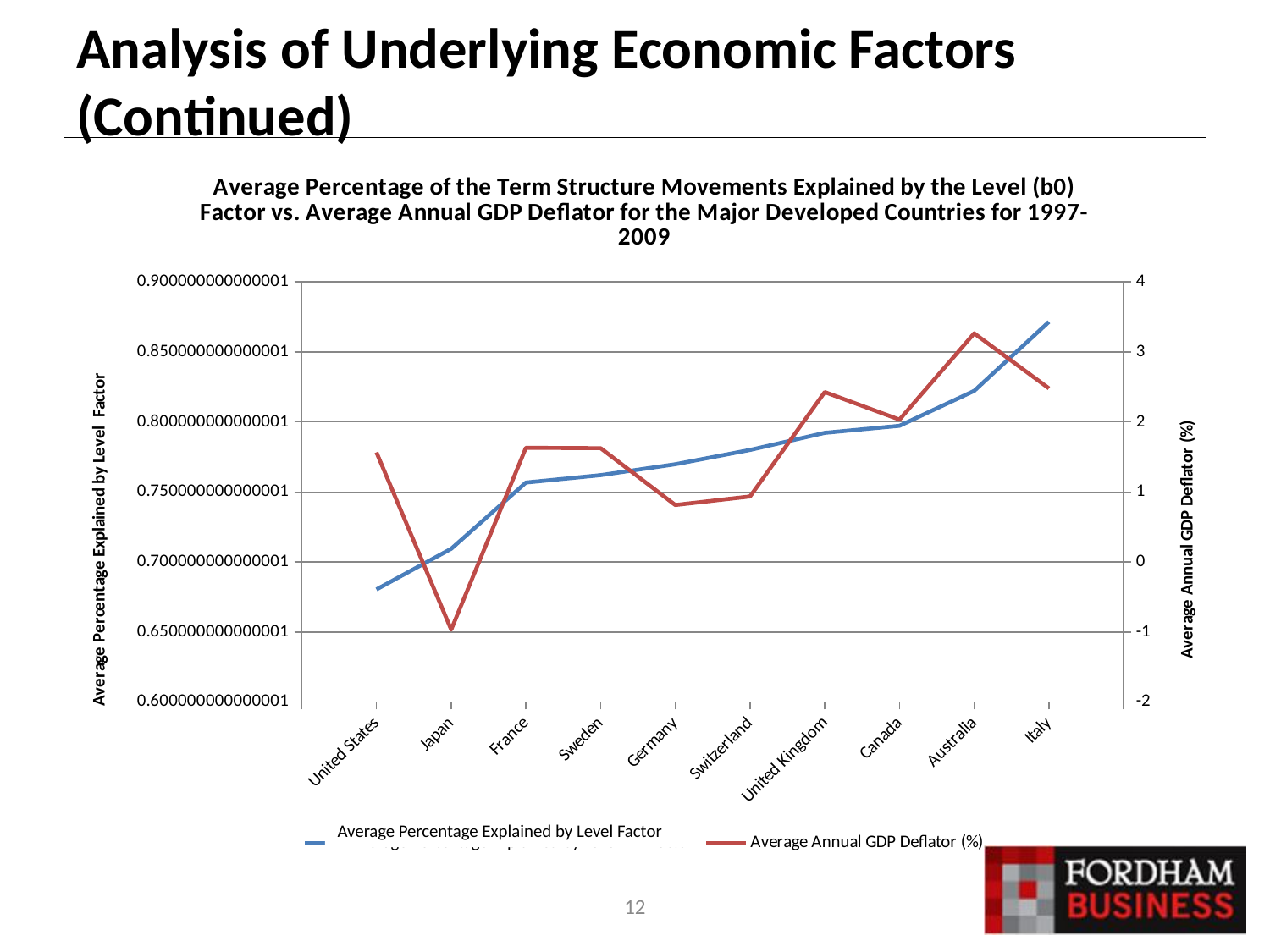
How many countries are plotted along the x axis? 10 Which country has the highest Average Percentage Explained by Level Factor? Italy Which country has the lowest Average Percentage Explained by Level Factor? United States Is the Average Percentage Explained by Level Factor for the United States greater or less than 0.7? less Which country has the highest Average Annual GDP Deflator (%)? Australia How many series does the legend list? 2 Is the Average Annual GDP Deflator (%) for Japan greater or less than 0? less Which country has the lowest Average Annual GDP Deflator (%)? Japan Which series is drawn in red according to the legend? Average Annual GDP Deflator (%) Is the Average Annual GDP Deflator (%) for Australia greater or less than 3? greater What kind of chart is shown on the slide? Line chart Does the Average Percentage Explained by Level Factor rise or fall moving from United States to Italy along the x axis? rise